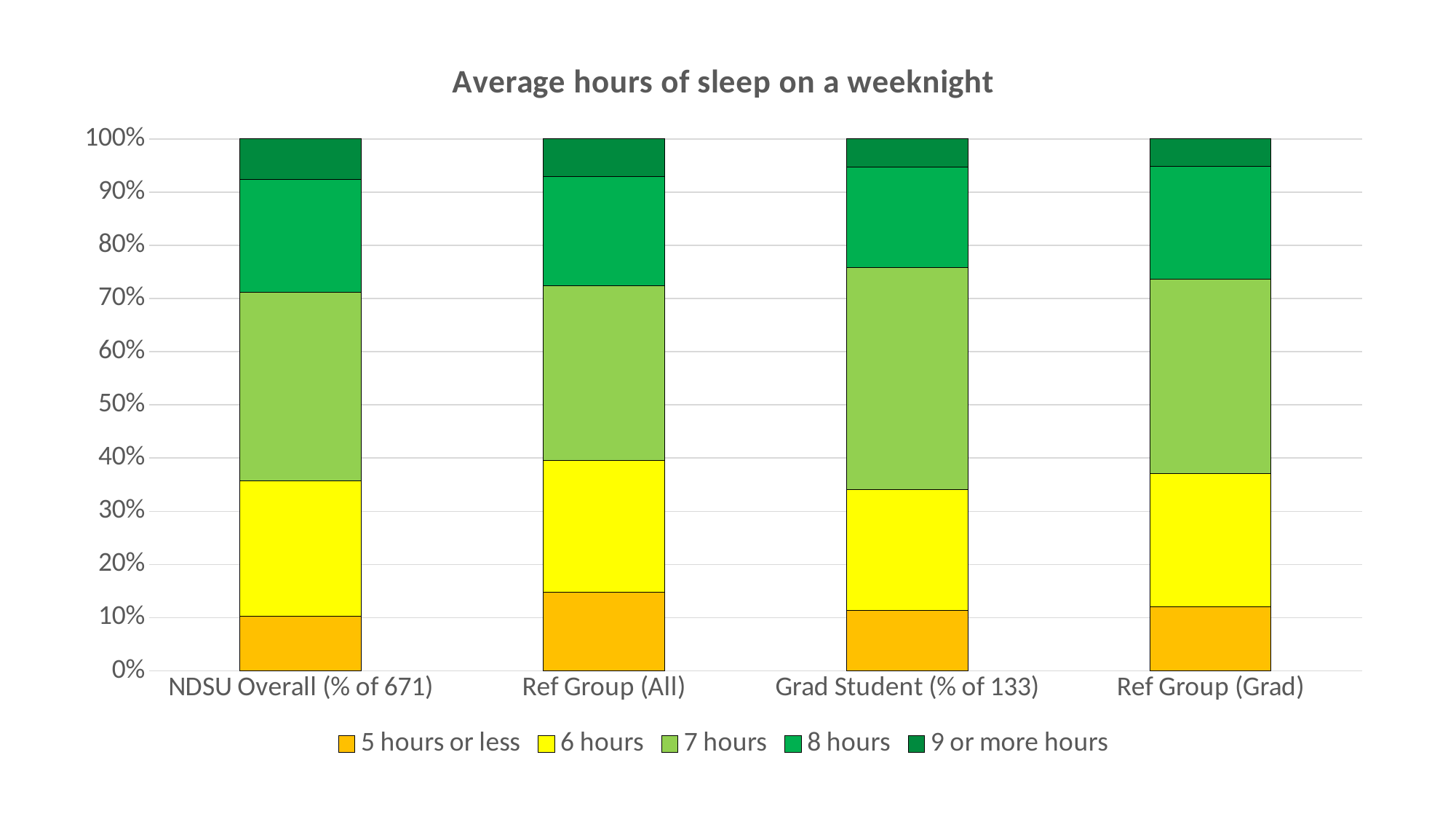
Which category has the largest 5 hours or less segment? Ref Group (All) What is the total height of the Ref Group (Grad) stacked bar? 100% Which is larger: the 5 hours or less share for Ref Group (All) or for NDSU Overall (% of 671)? Ref Group (All) Is the 6 hours share for NDSU Overall (% of 671) greater or less than 20%? greater Which colour represents the 6 hours series in the legend? Yellow How many series does the legend list? 5 Is the 9 or more hours share for Grad Student (% of 133) greater or less than 10%? less What kind of chart is shown on the slide? Stacked bar chart How many categories are shown along the x axis? 4 Is the 5 hours or less share for Ref Group (All) greater or less than 10%? greater Which category has the largest 7 hours segment? Grad Student (% of 133) What is the title of the chart? Average hours of sleep on a weeknight